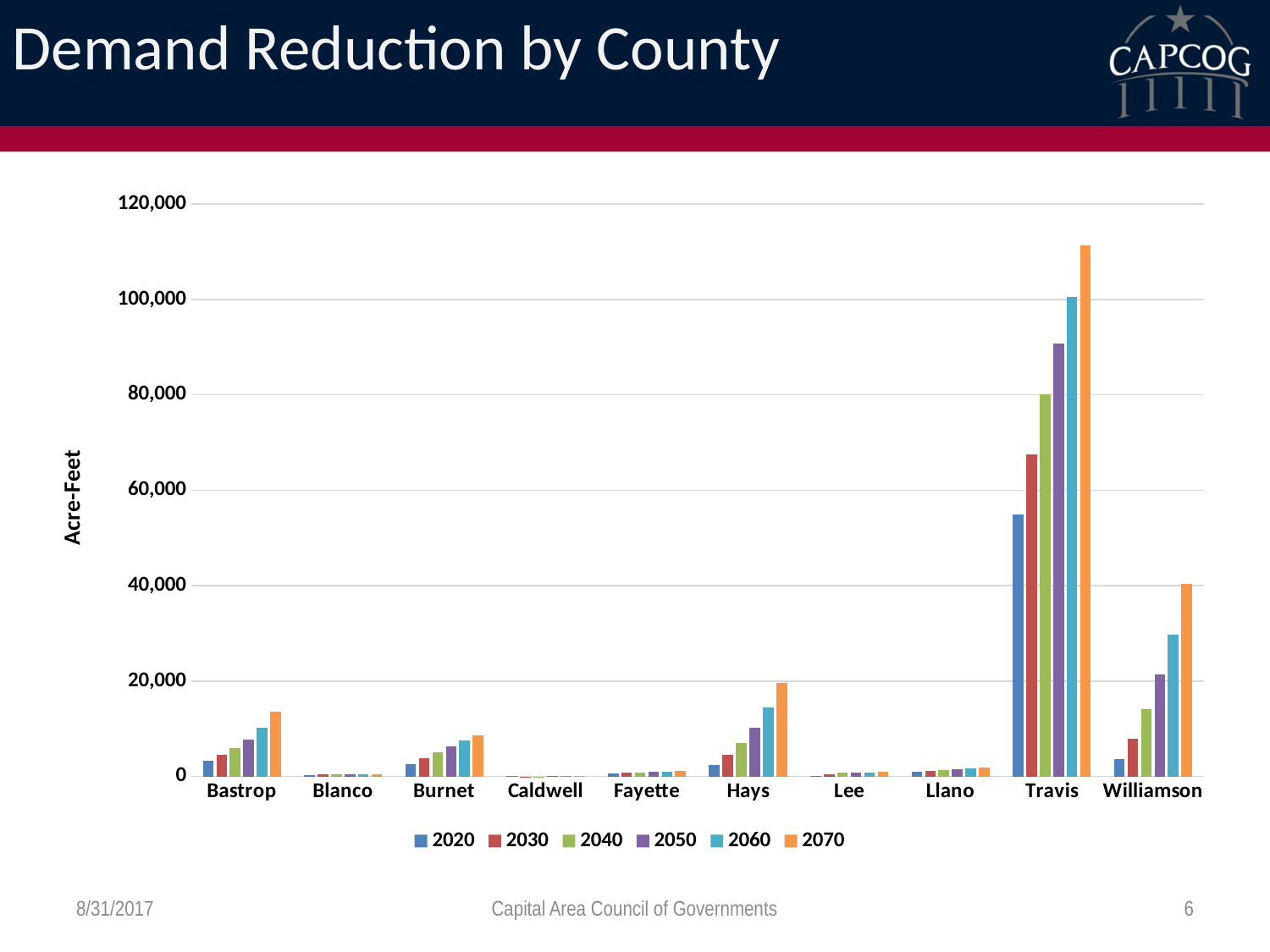
Is the 2060 value for Williamson greater or less than 20,000? greater Which is larger, the 2070 value for Hays or the 2070 value for Bastrop? Hays Which is larger, the 2030 value for Travis or the 2070 value for Williamson? Travis 2030 Is the 2020 value for Travis greater or less than 60,000? less Do the values for Travis rise or fall from 2020 to 2070? rise Is the 2050 value for Travis greater or less than 80,000? greater How many counties are shown on the x axis? 10 What kind of chart is shown on the slide? bar chart How many series does the legend list? 6 Which county has the highest 2070 value? Travis What is the label on the y axis? Acre-Feet